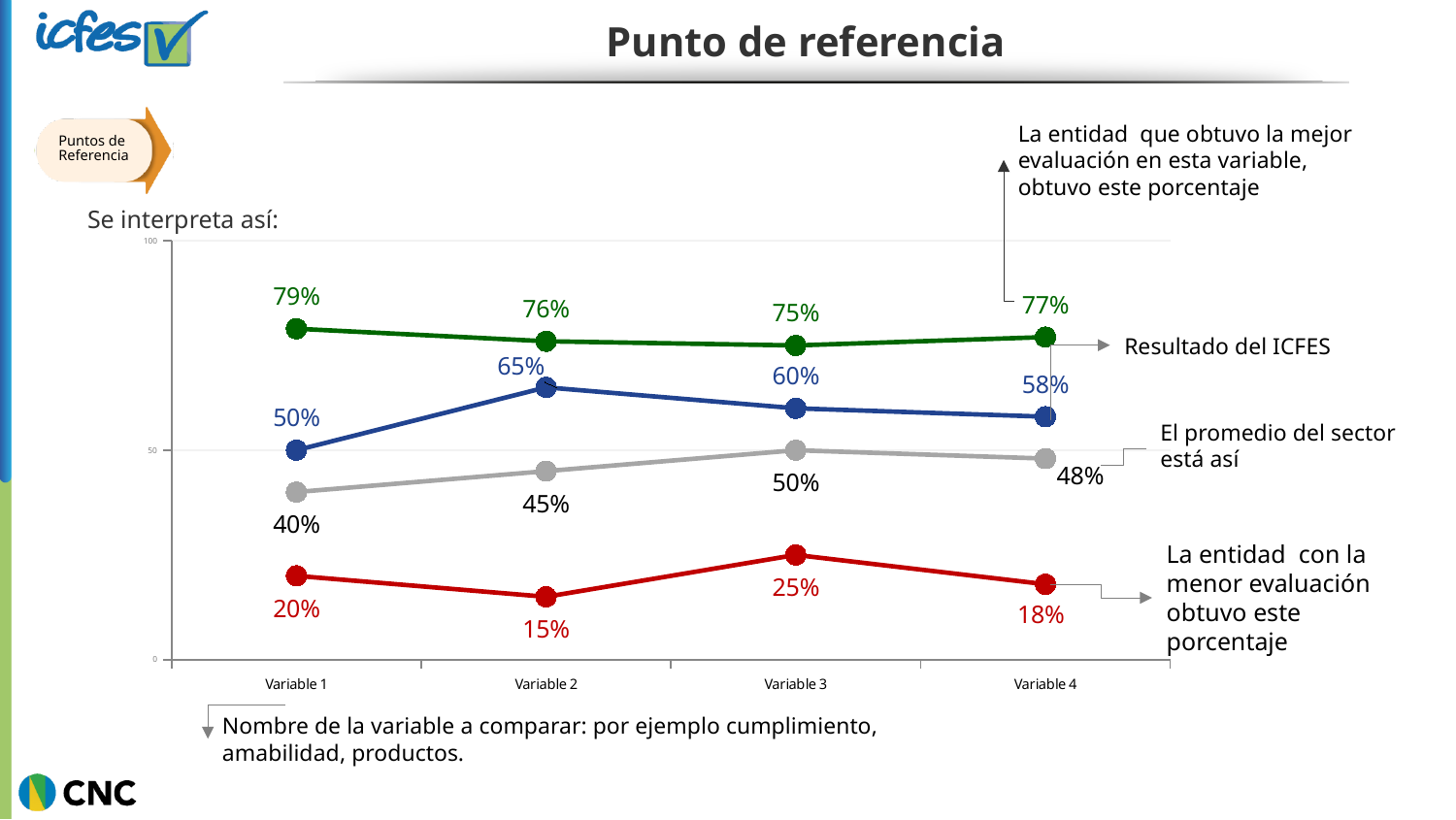
Which is larger for Variable 3: the blue line (Resultado del ICFES) or the gray line (sector average)? the blue line (Resultado del ICFES) How many variables (categories) are shown on the x axis of the chart? 4 What is the value of the blue line (Resultado del ICFES) for Variable 2? 65% What is the value of the green line (best-evaluated entity) for Variable 1? 79% For which variable is the red line (lowest-evaluated entity) at its lowest value? Variable 2 What is the difference between the green line and the blue line for Variable 1? 29% What is the title of the slide containing the chart? Punto de referencia For which variable is the blue line (Resultado del ICFES) at its highest value? Variable 2 What type of chart is shown on the slide? line chart What is the value of the red line (lowest-evaluated entity) for Variable 3? 25% What is the value of the gray line (sector average) for Variable 4? 48% Does the gray line (sector average) rise or fall from Variable 1 to Variable 3? rise